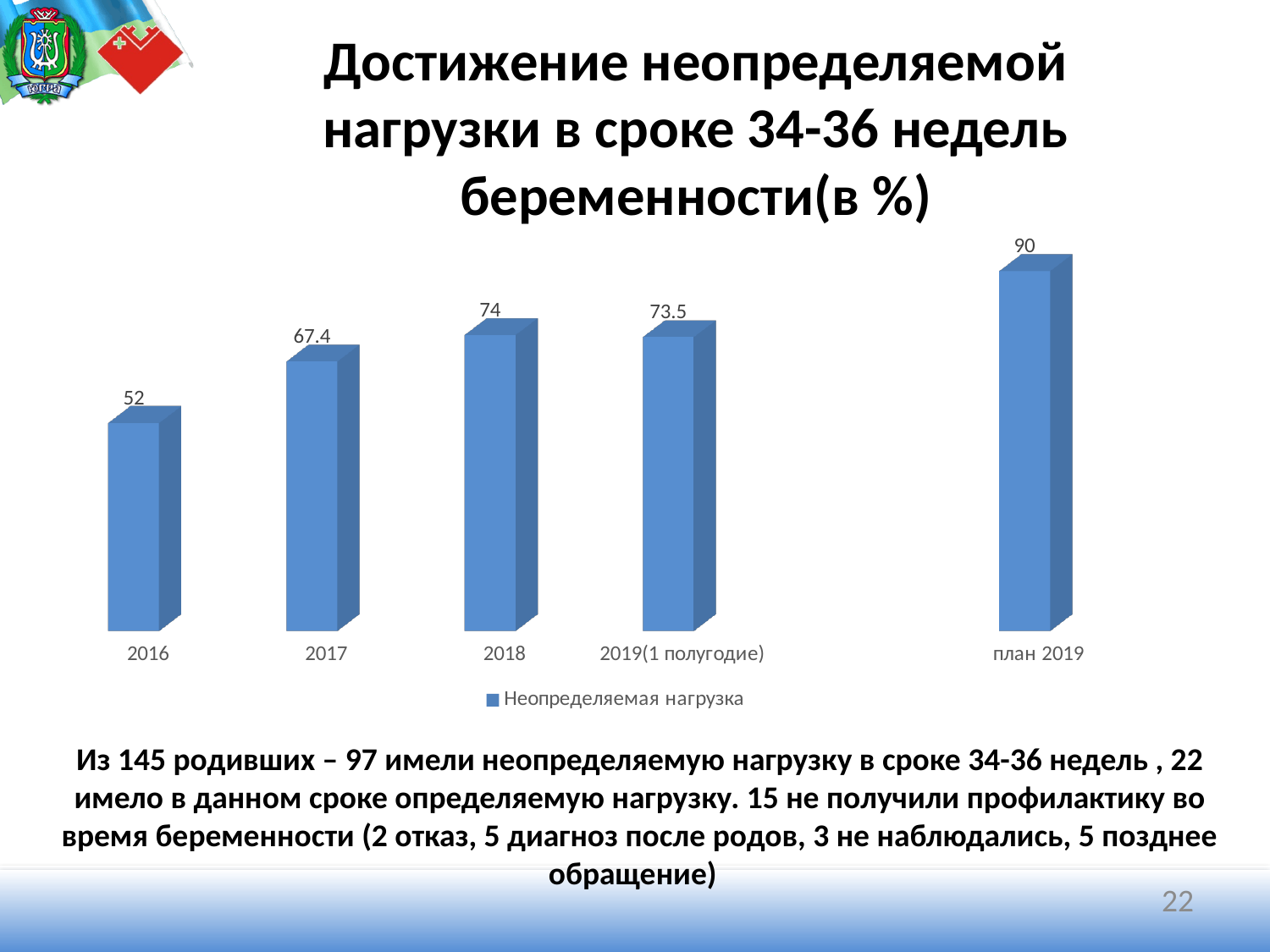
What is the value for 2017? 67.4 What is the value for 2018? 74 What is the value for план 2019? 90 What is the difference between the values for 2018 and 2016? 22 What series name is listed in the legend? Неопределяемая нагрузка Which category has the lowest value? 2016 Which is larger, the value for 2017 or the value for 2016? 2017 What is the value for 2016? 52 How many categories are shown on the x axis? 5 Which category has the highest value? план 2019 What kind of chart is shown on the slide? bar chart What is the value for 2019(1 полугодие)? 73.5